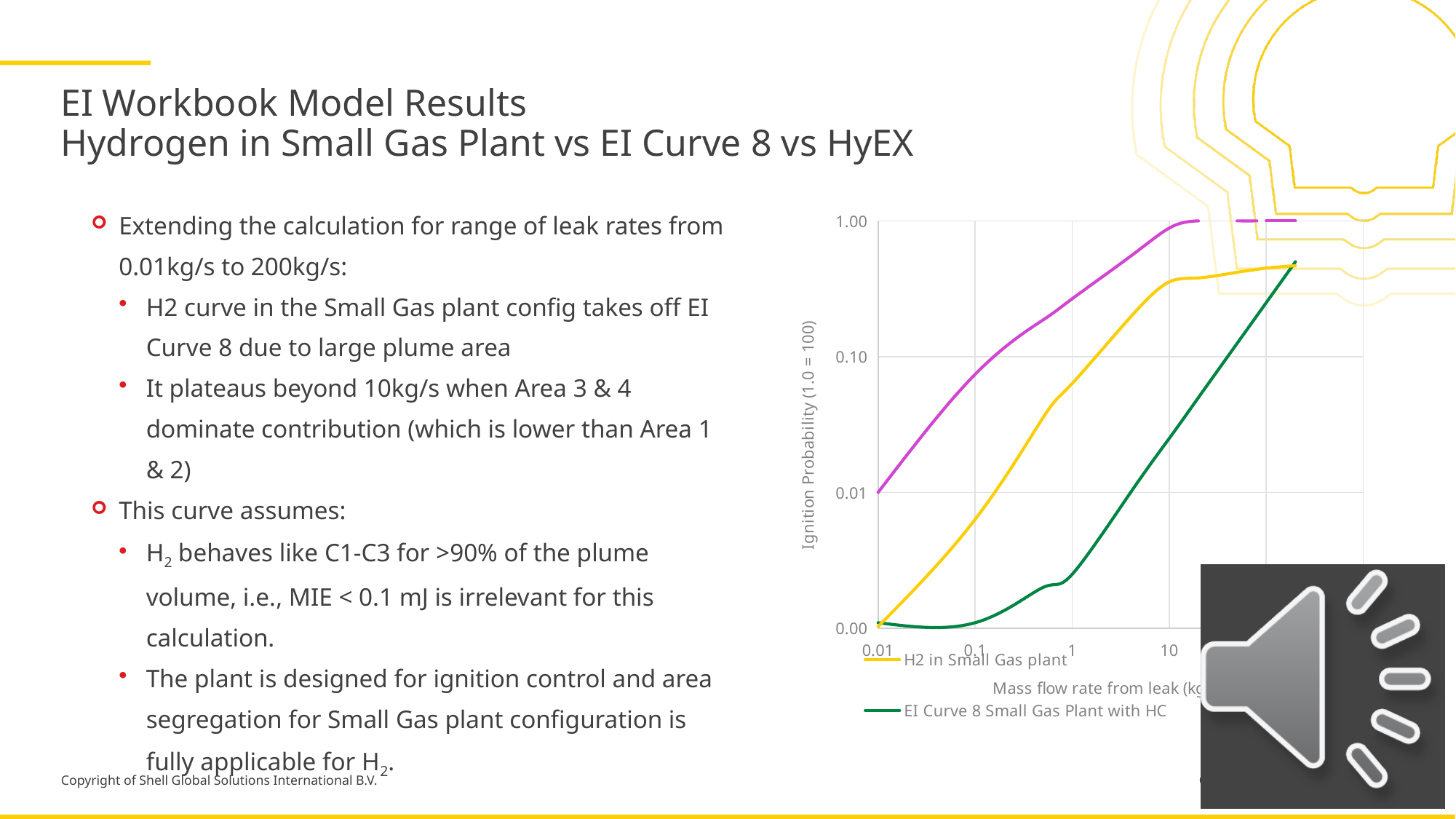
At a mass flow rate of 0.1 kg/s, which is lower: 'H2 in Small Gas plant' or 'EI Curve 8 Small Gas Plant with HC'? EI Curve 8 Small Gas Plant with HC At a mass flow rate of 1 kg/s, which is higher: 'H2 in Small Gas plant' or 'EI Curve 8 Small Gas Plant with HC'? H2 in Small Gas plant What colour is the line for 'H2 in Small Gas plant'? yellow What is the label of the y axis of the chart? Ignition Probability (1.0 = 100) Does the 'H2 in Small Gas plant' line rise or fall as mass flow rate increases? rise Of the two labelled lines, which has the lower ignition probability at 10 kg/s? EI Curve 8 Small Gas Plant with HC What kind of chart is shown on the slide? line chart Does the 'EI Curve 8 Small Gas Plant with HC' line overall rise or fall as mass flow rate increases from 0.1 to 100 kg/s? rise Is the value of 'H2 in Small Gas plant' at a mass flow rate of 1 kg/s greater or less than 0.10? less How many lines are plotted on the chart? 3 Is the value of 'H2 in Small Gas plant' at a mass flow rate of 10 kg/s greater or less than 0.10? greater Is the value of 'EI Curve 8 Small Gas Plant with HC' at a mass flow rate of 1 kg/s greater or less than 0.01? less